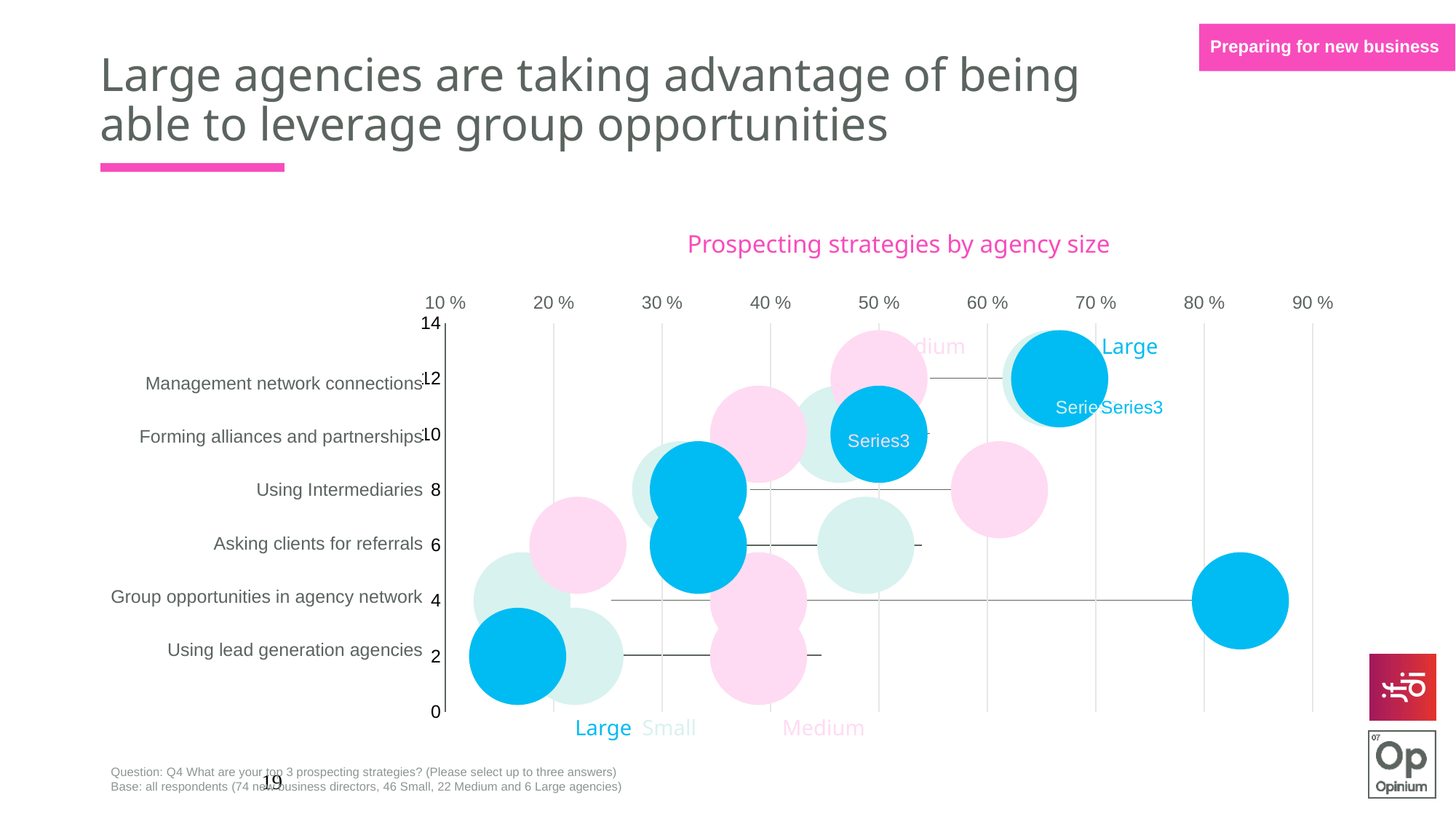
Which colour represents Large agencies in the chart? Blue Which prospecting strategy has the highest value for Large agencies? Group opportunities in agency network Is the value for Large agencies on 'Group opportunities in agency network' greater or less than 80%? greater For 'Group opportunities in agency network', which agency size has the larger value, Large or Small? Large Is the value for Large agencies on 'Management network connections' greater or less than 60%? greater How many agency-size series does the chart show? 3 Is the value for Large agencies on 'Using lead generation agencies' greater or less than 20%? less For 'Management network connections', which agency size has the larger value, Large or Medium? Large What is the title of the chart? Prospecting strategies by agency size How many prospecting strategies (categories) are listed on the chart's vertical axis? 6 What kind of chart is shown on the slide? Bubble chart